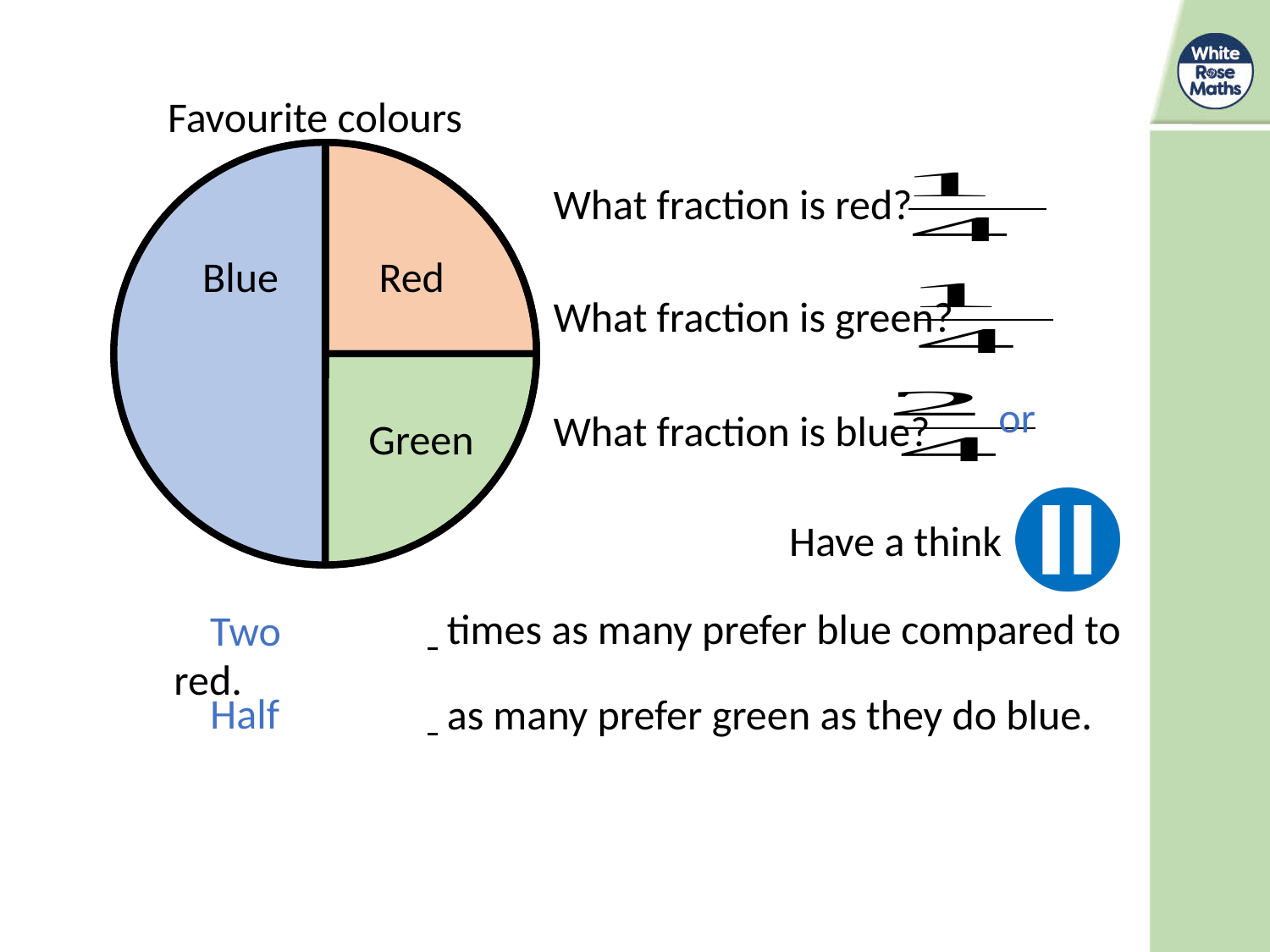
What fraction of the pie chart is green? 1/4 Which colour is shown in the slice on the left half of the pie chart? Blue Which slice is larger, Blue or Red? Blue Which colour has the largest slice of the pie chart? Blue How many slices does the pie chart have? 3 Which slice is larger, Blue or Green? Blue What fraction of the pie chart is red? 1/4 What is the title of the chart? Favourite colours How many times as many people prefer blue compared to red, according to the slide? Two What fraction of the pie chart is blue? 2/4 What kind of chart is shown on the slide? pie chart